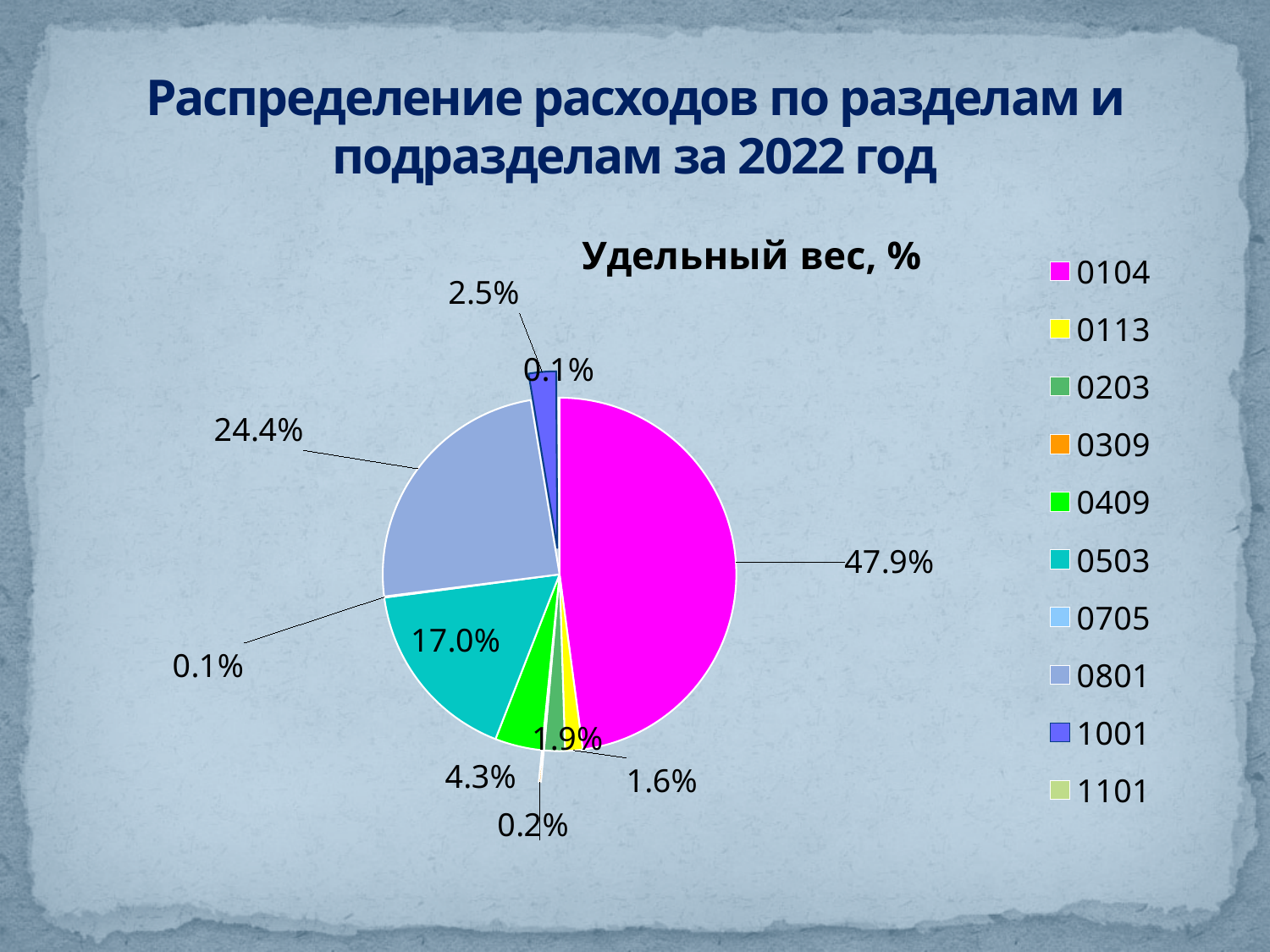
What is the value for 0801 in the pie chart? 24.4% What is the value for 0104 in the pie chart? 47.9% Which is larger, the value for 0503 or the value for 0801? 0801 What kind of chart is shown on the slide? Pie chart What is the value for 0409 in the pie chart? 4.3% What is the value for 0503 in the pie chart? 17.0% What is the difference between the values for 0801 and 0503? 7.4% What is the title of the chart? Удельный вес, % What is the difference between the values for 0104 and 0801? 23.5% What is the value for 1001 in the pie chart? 2.5% How many categories does the legend of the pie chart list? 10 Which category has the largest slice of the pie chart? 0104